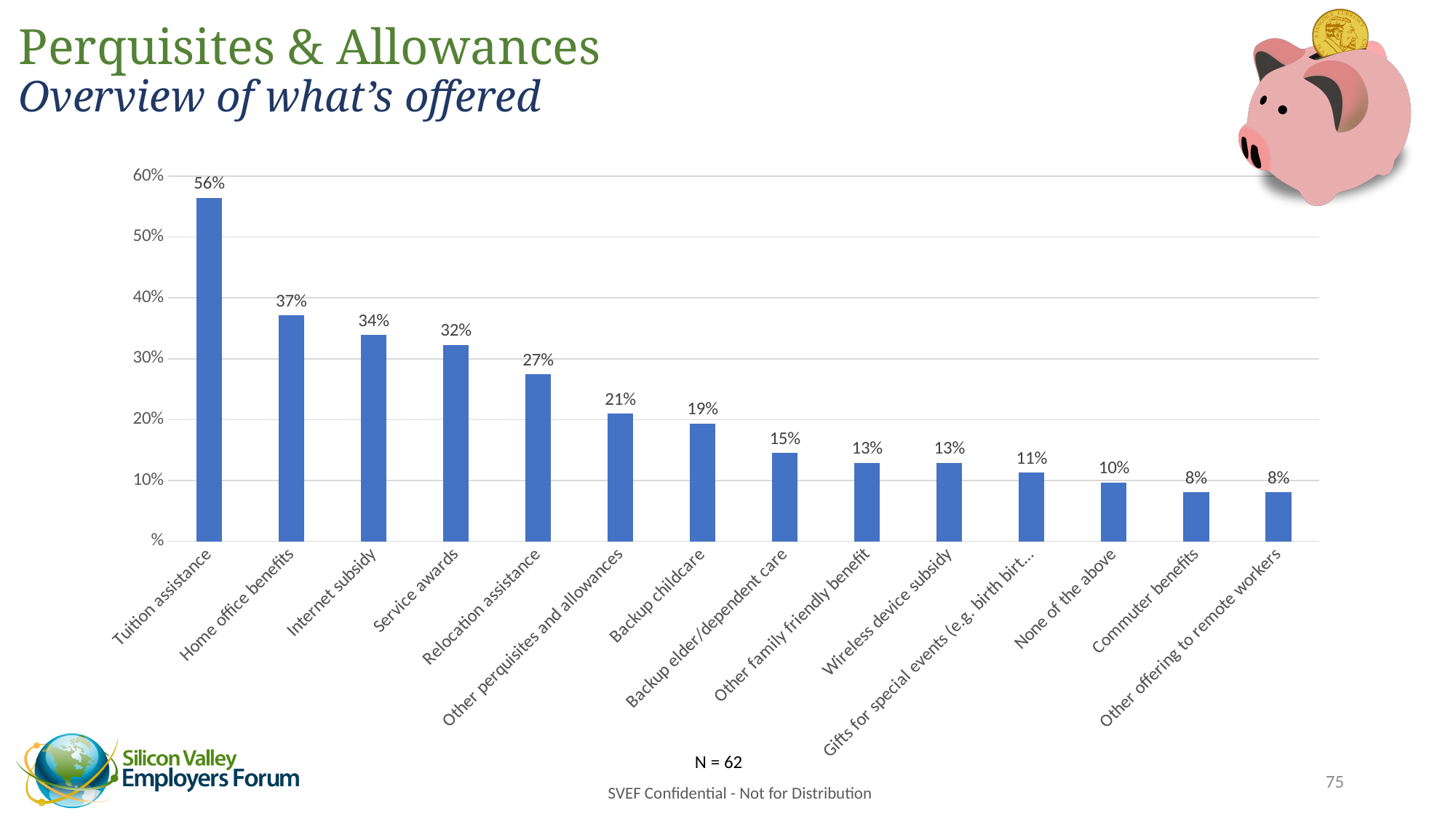
What value is shown for None of the above? 10% What is the sample size (N) noted below the chart? N = 62 What type of chart is shown on the slide? Bar chart How many categories are shown on the chart? 14 What is the difference between the values for Home office benefits and Internet subsidy? 3% What percentage of respondents offer tuition assistance? 56% What is the difference between Tuition assistance and Service awards? 24% Which perquisite or allowance has the highest percentage? Tuition assistance Is the value for Other perquisites and allowances greater or less than 20%? greater Which is larger, the value for Backup elder/dependent care or the value for Wireless device subsidy? Backup elder/dependent care What is the value shown for Relocation assistance? 27% What percentage is shown for Backup childcare? 19%